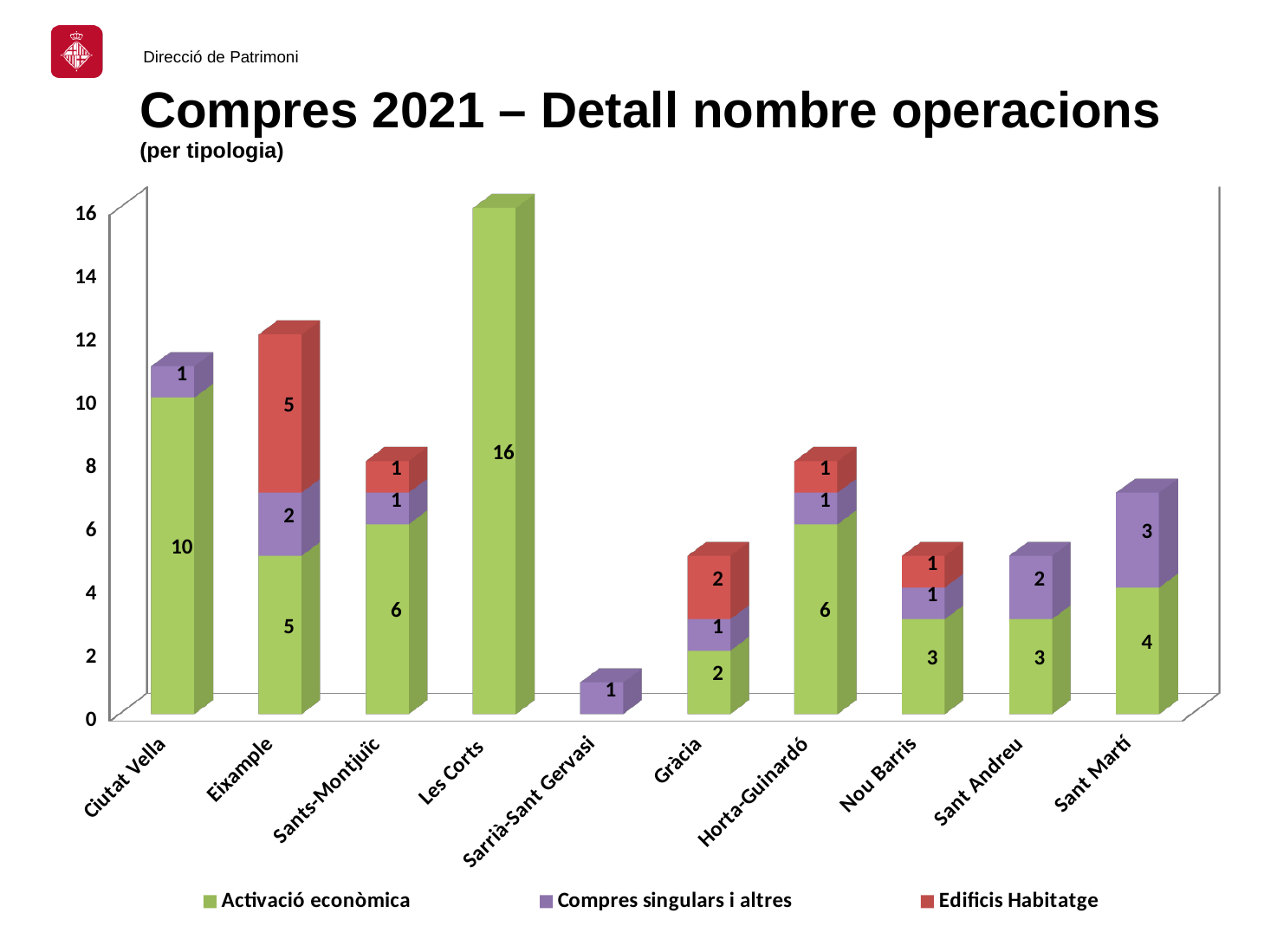
What is the difference between the Activació econòmica values for Les Corts and Ciutat Vella? 6 What is the Activació econòmica value for Les Corts? 16 Which district has the highest Activació econòmica value? Les Corts How many districts are shown on the x axis? 10 How many series does the legend list? 3 Which district has the lowest total stacked bar? Sarrià-Sant Gervasi What is the Activació econòmica value for Ciutat Vella? 10 What is the total of the stacked bar for Eixample? 12 What is the Compres singulars i altres value for Sant Martí? 3 Which is larger, the Activació econòmica value for Sants-Montjuïc or for Sant Martí? Sants-Montjuïc What is the Edificis Habitatge value for Eixample? 5 What is the total of the stacked bar for Gràcia? 5